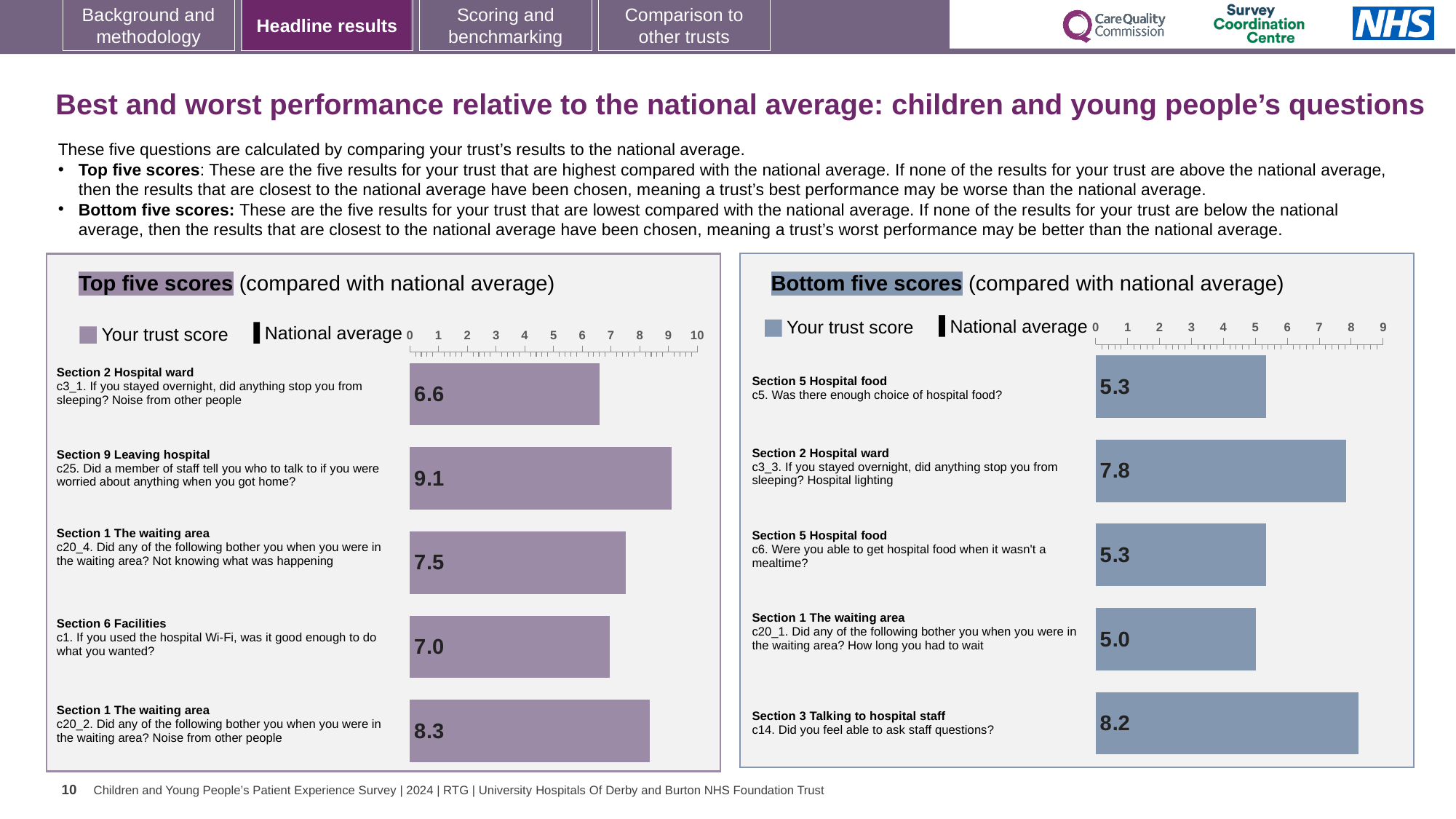
In the 'Top five scores' chart, what is the difference between the trust scores for c20_2 and c20_4? 0.8 In the 'Top five scores' chart, what is the trust score for c25 (Did a member of staff tell you who to talk to if you were worried about anything when you got home?)? 9.1 In the 'Bottom five scores' chart, what is the trust score for c20_1 (How long you had to wait)? 5.0 In the 'Bottom five scores' chart, which question has the lowest trust score? c20_1. Did any of the following bother you when you were in the waiting area? How long you had to wait In the 'Top five scores' chart, which question has the lowest trust score? c3_1. If you stayed overnight, did anything stop you from sleeping? Noise from other people In the 'Bottom five scores' chart, what is the trust score for c3_3 (Hospital lighting)? 7.8 How many questions are shown in the 'Bottom five scores' chart? 5 In the 'Top five scores' chart, which question has the highest trust score? c25. Did a member of staff tell you who to talk to if you were worried about anything when you got home? In the 'Bottom five scores' chart, is the trust score for c14 larger or smaller than the trust score for c3_3? larger In the 'Bottom five scores' chart, which question has the highest trust score? c14. Did you feel able to ask staff questions? In the 'Top five scores' chart, what is the trust score for c1 (If you used the hospital Wi-Fi, was it good enough to do what you wanted?)? 7.0 What kind of chart is the 'Top five scores' chart? bar chart